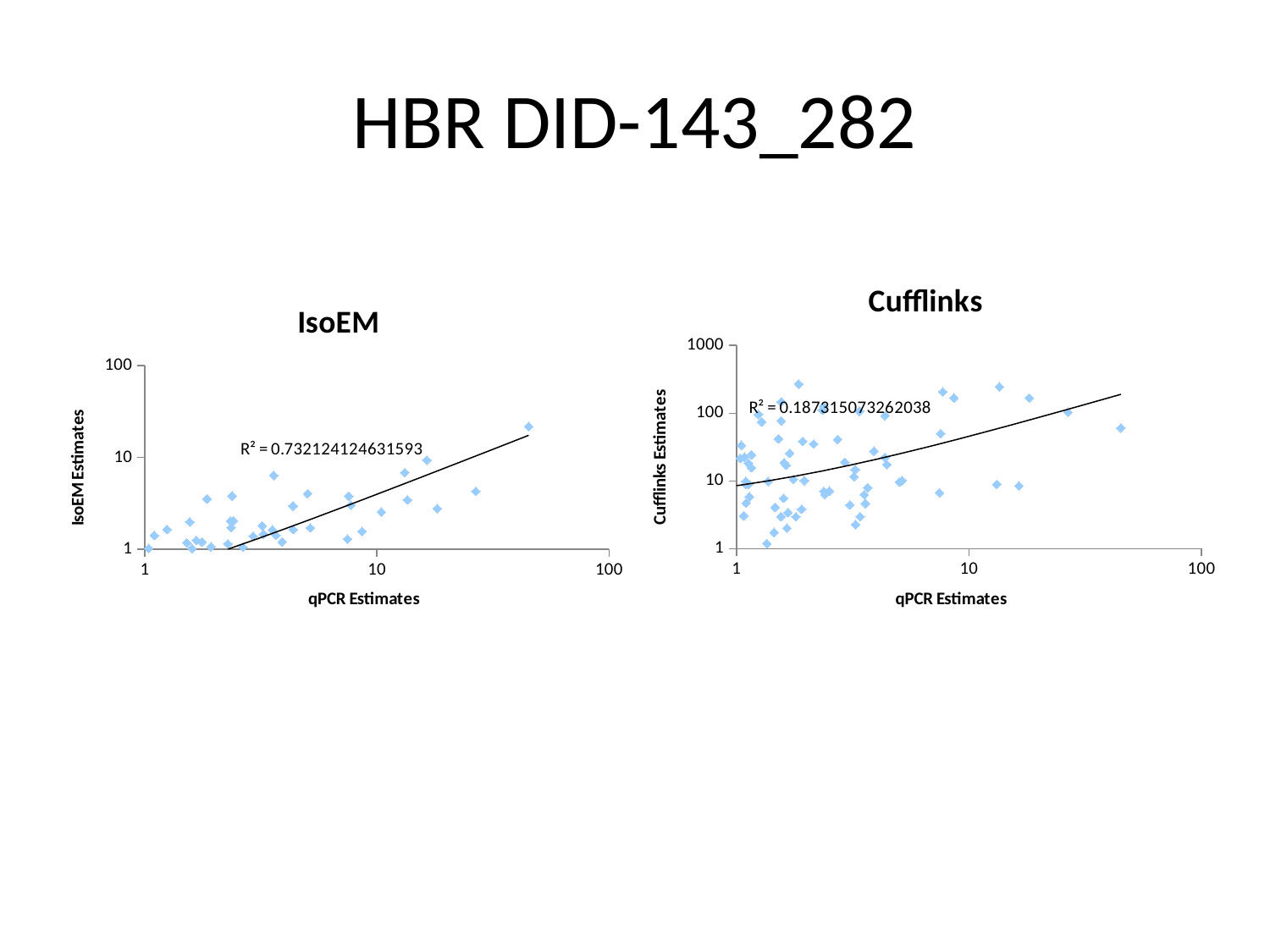
In the IsoEM chart, do the estimates generally rise or fall as qPCR Estimates increase along the x axis? rise What kind of chart is the IsoEM chart? scatter chart What is the x-axis title of the Cufflinks chart? qPCR Estimates In the IsoEM chart, is the highest plotted IsoEM Estimate greater or less than 10? greater In the Cufflinks chart, is the highest plotted Cufflinks Estimate greater or less than 100? greater How many charts are shown on the slide? 2 In the Cufflinks chart, what R² value is printed? R² = 0.187315073262038 In the IsoEM chart, what R² value is printed? R² = 0.732124124631593 What is the highest tick value shown on the y axis of the Cufflinks chart? 1000 Which chart shows the higher R² value, IsoEM or Cufflinks? IsoEM In the Cufflinks chart, does the fitted trend line rise or fall along the x axis? rise What kind of chart is the Cufflinks chart? scatter chart